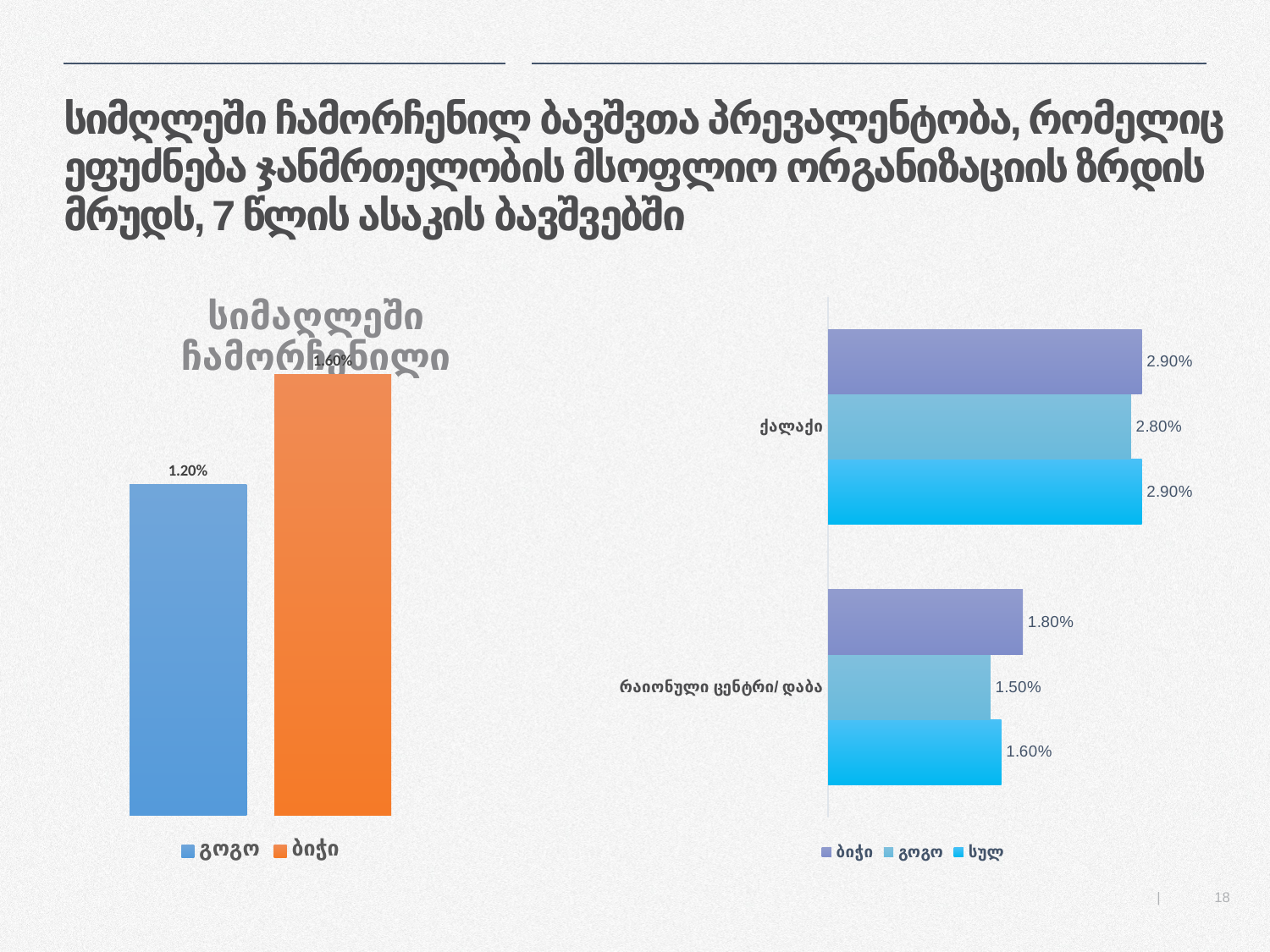
In the right chart, what is the value for გოგო in the რაიონული ცენტრი/ დაბა category? 1.50% In the left chart titled "სიმაღლეში ჩამორჩენილი", which category has the higher value? ბიჭი In the right chart, which is larger: the value for ბიჭი in ქალაქი or the value for ბიჭი in რაიონული ცენტრი/ დაბა? ბიჭი in ქალაქი In the right chart, what is the value for გოგო in the ქალაქი category? 2.80% In the right chart, what is the value for ბიჭი in the ქალაქი category? 2.90% In the right chart, how many series does the legend list? 3 What kind of chart is the left chart titled "სიმაღლეში ჩამორჩენილი"? bar chart In the left chart titled "სიმაღლეში ჩამორჩენილი", what is the value for გოგო? 1.20% In the left chart titled "სიმაღლეში ჩამორჩენილი", what is the difference between the values for ბიჭი and გოგო? 0.40% In the right chart, what is the difference between the ბიჭი values for ქალაქი and რაიონული ცენტრი/ დაბა? 1.10% In the right chart, what is the value for სულ in the რაიონული ცენტრი/ დაბა category? 1.60% In the left chart titled "სიმაღლეში ჩამორჩენილი", what is the value for ბიჭი? 1.60%